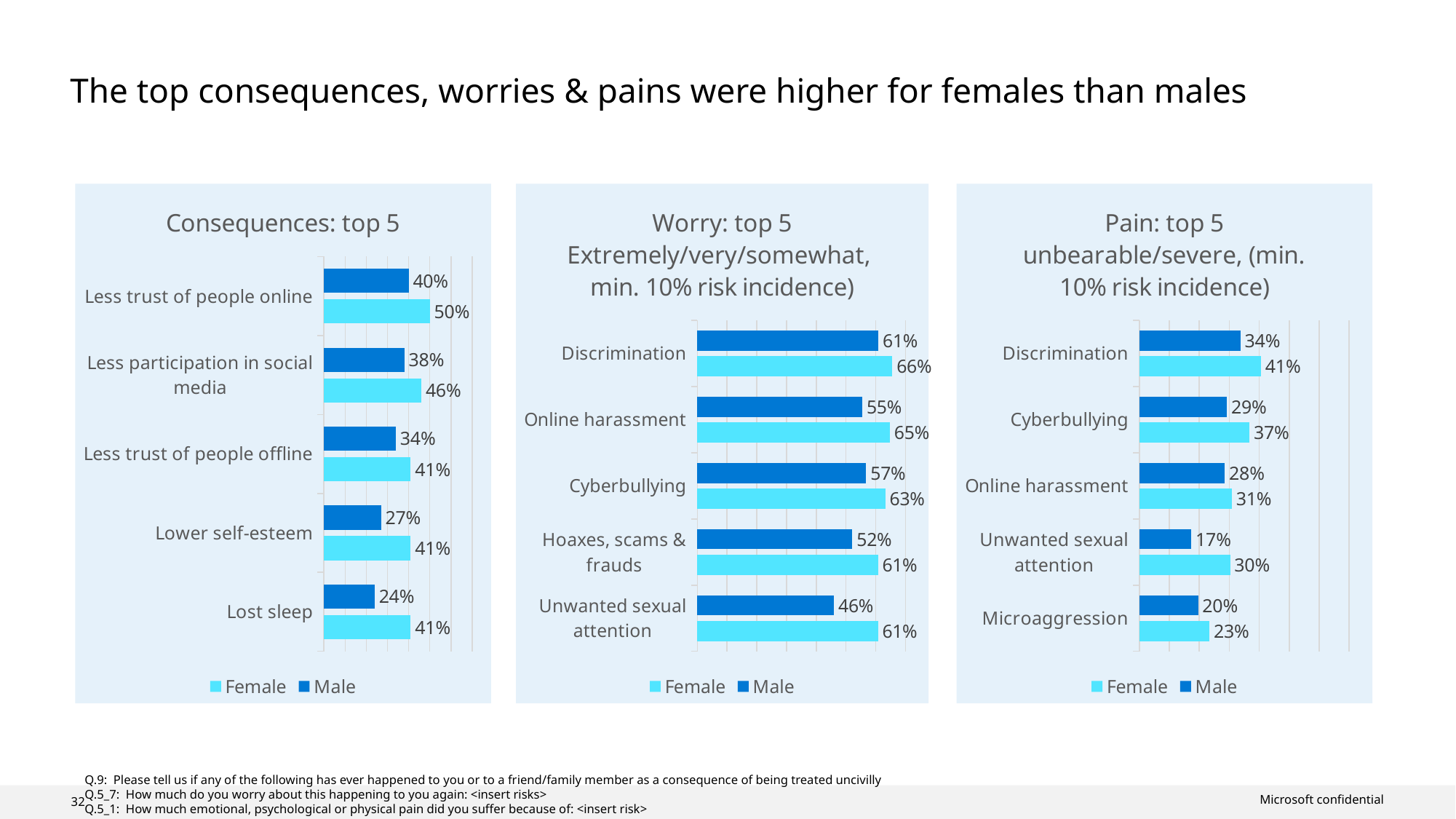
In the 'Pain: top 5' chart, which is larger: the Male value for 'Cyberbullying' or the Male value for 'Microaggression'? Cyberbullying In the 'Worry: top 5' chart, what is the difference between the Female and Male values for 'Unwanted sexual attention'? 15 percentage points In the 'Consequences: top 5' chart, which category has the lowest Male value? Lost sleep How many series does the legend of the 'Worry: top 5' chart list? 2 In the 'Worry: top 5' chart, what is the Female value for 'Online harassment'? 65% How many categories are shown in the 'Pain: top 5' chart? 5 In the 'Consequences: top 5' chart, what is the Male value for 'Lost sleep'? 24% What type of chart is the 'Consequences: top 5' chart? Bar chart In the 'Consequences: top 5' chart, what is the Female value for 'Less trust of people online'? 50% In the 'Consequences: top 5' chart, what is the difference between the Female and Male values for 'Lower self-esteem'? 14 percentage points In the 'Worry: top 5' chart, which category has the highest Male value? Discrimination In the 'Pain: top 5' chart, what is the Male value for 'Unwanted sexual attention'? 17%